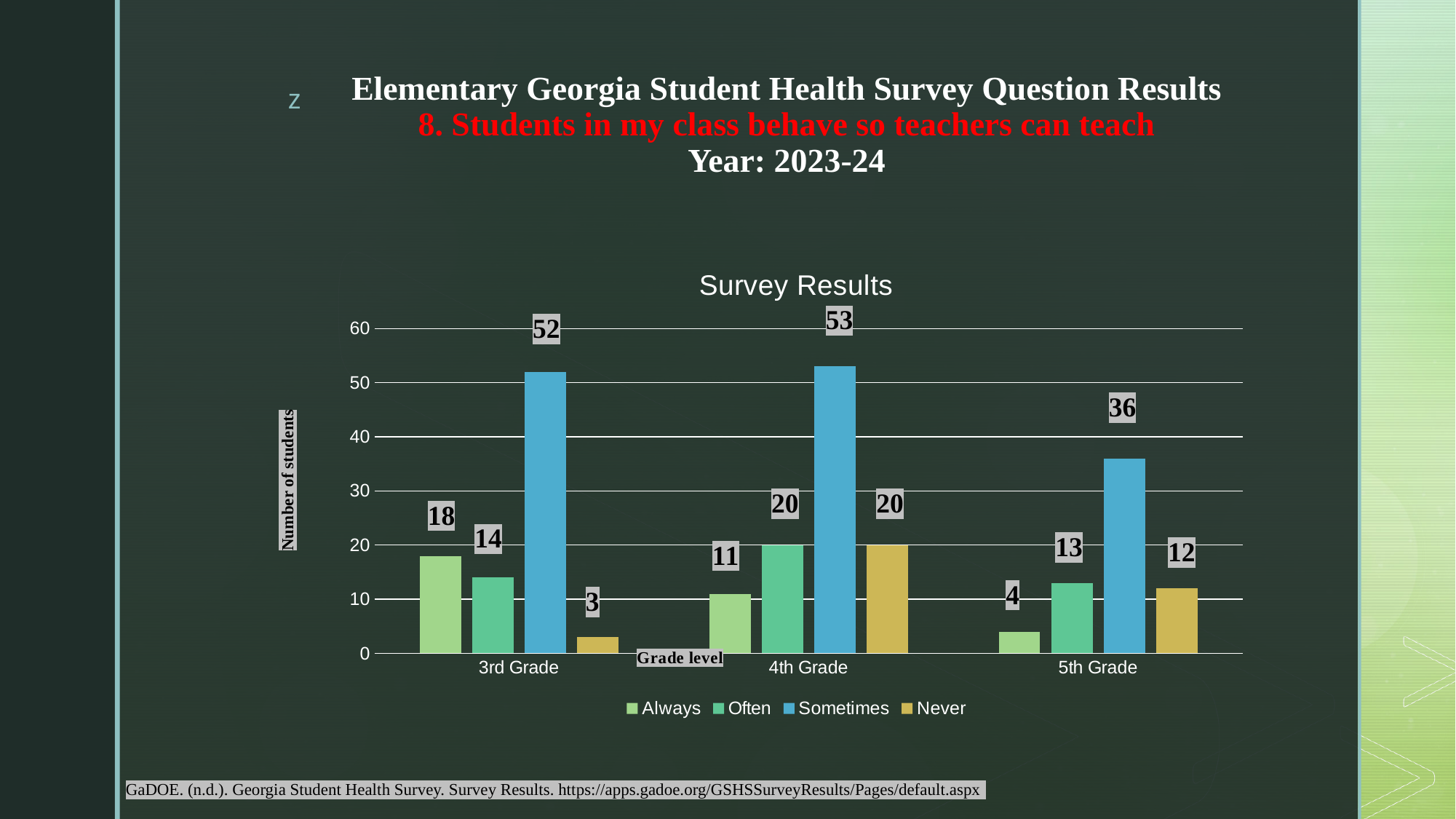
What is the value for Never in 4th Grade? 20 Which grade has the lowest value for Never? 3rd Grade How many series does the legend list? 4 How many grade levels are shown on the x axis? 3 What is the difference between the Sometimes values for 4th Grade and 5th Grade? 17 What is the value for Sometimes in 3rd Grade? 52 Is the value for Sometimes in 5th Grade greater or less than 30? greater What is the title of the chart? Survey Results What kind of chart is shown? Bar chart Which is larger, the Always value for 3rd Grade or the Always value for 4th Grade? 3rd Grade Which grade has the highest value for Sometimes? 4th Grade What is the value for Always in 5th Grade? 4